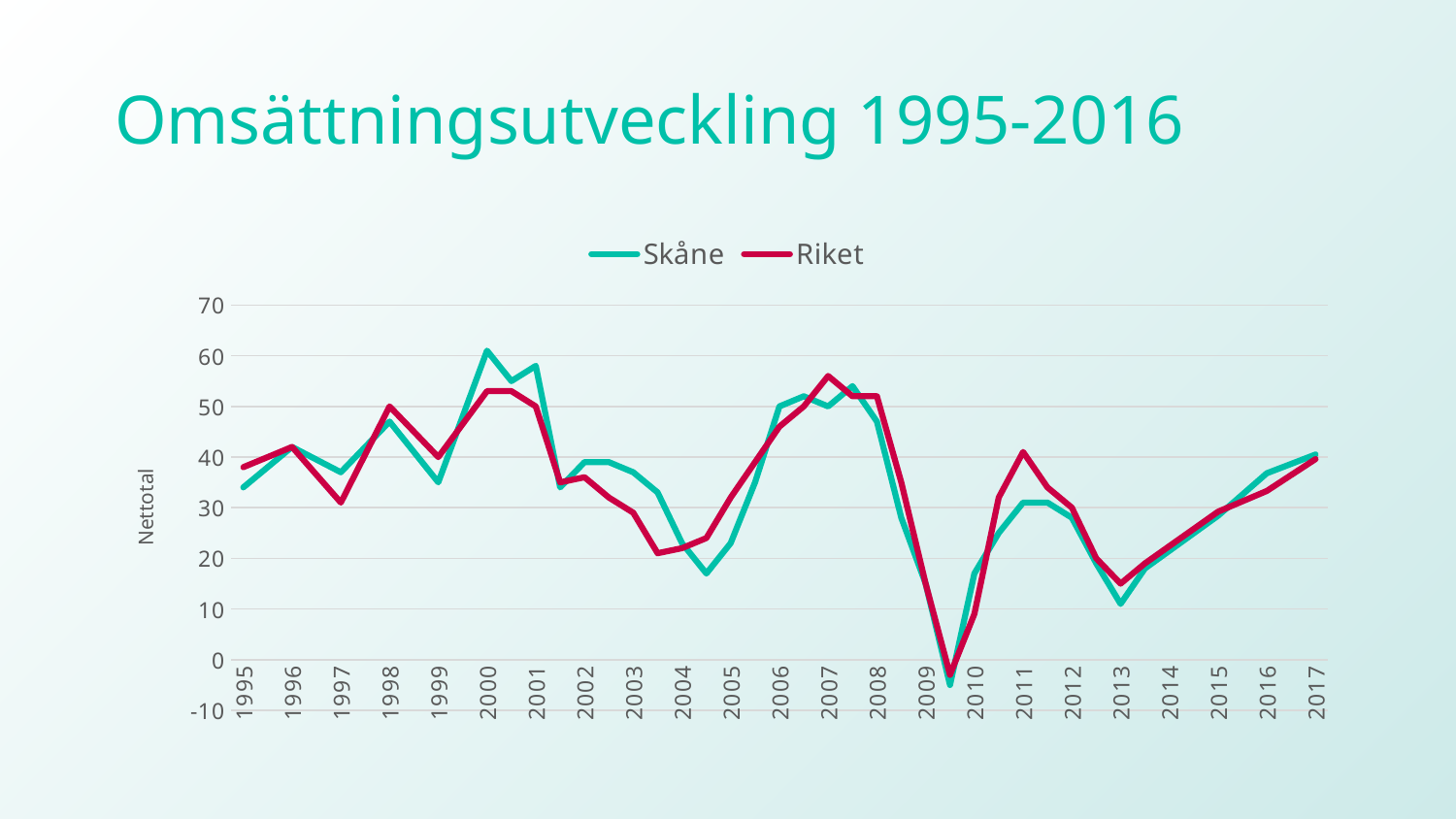
Do the values for both series rise or fall from 2013 to 2017? rise Is the value for Skåne in 2000 greater or less than 50? greater In 2011, which series has the higher value, Skåne or Riket? Riket What is the title of the chart? Omsättningsutveckling 1995-2016 Which two series are listed in the legend? Skåne and Riket What kind of chart is shown on the slide? line chart How many series does the legend list? 2 Is the value for Skåne in 2013 greater or less than 20? less In which year does the Riket line reach its lowest value? 2009 In which year does the Skåne line reach its highest value? 2000 How many years are shown on the x axis? 23